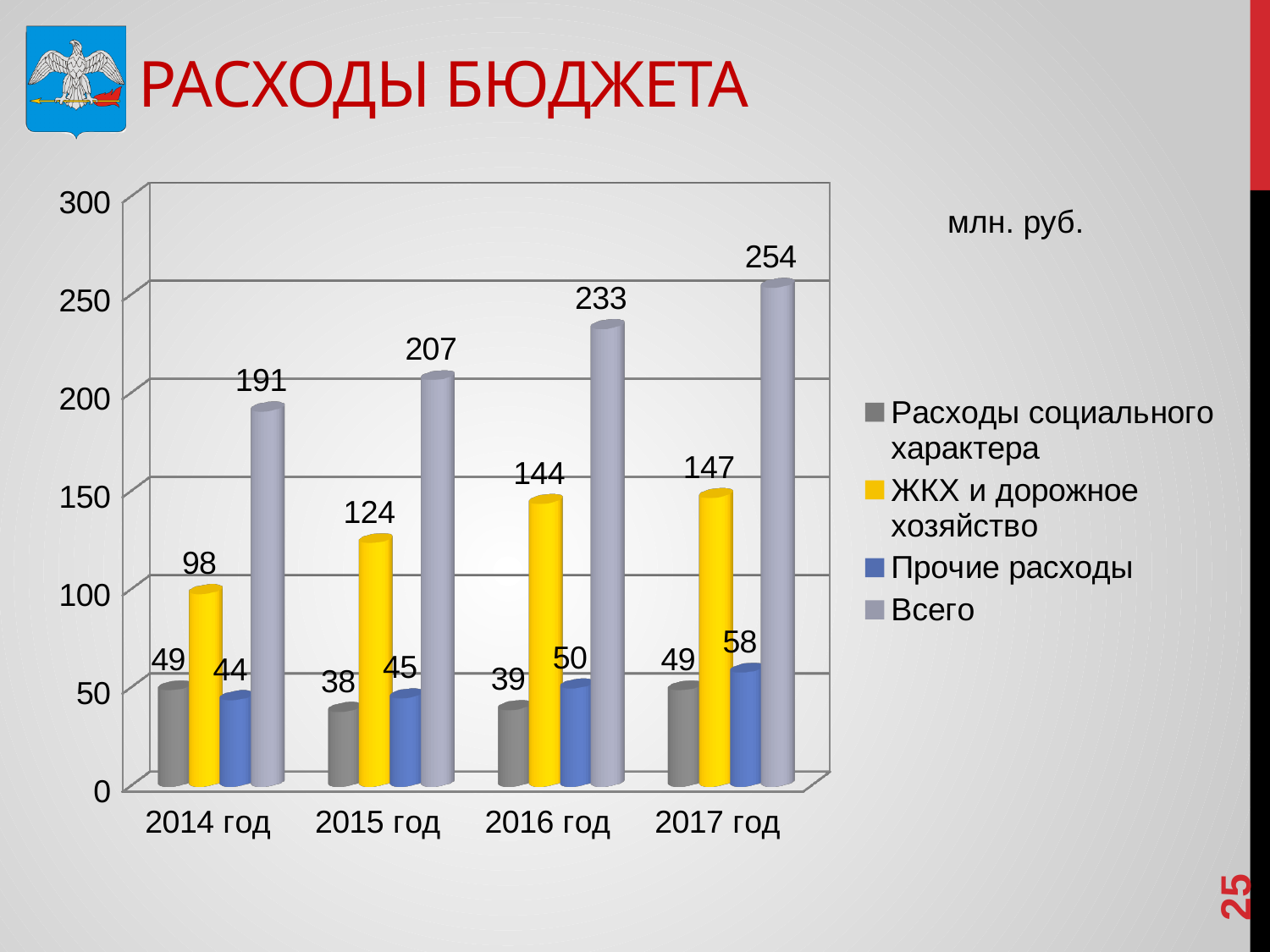
How many years are shown on the x axis? 4 What is the value of «ЖКХ и дорожное хозяйство» for 2015 год? 124 What kind of chart is shown on the slide? Bar chart In which year is «Всего» the highest? 2017 год How many series does the legend list? 4 What is the difference between «Всего» in 2017 год and «Всего» in 2014 год? 63 In which year is «Расходы социального характера» the lowest? 2015 год What is the value of «Расходы социального характера» for 2016 год? 39 What is the value of «Всего» for 2017 год? 254 What is the value of «Прочие расходы» for 2014 год? 44 Does «Всего» rise or fall from 2014 год to 2017 год? Rises Which is larger: «ЖКХ и дорожное хозяйство» in 2016 год or «ЖКХ и дорожное хозяйство» in 2015 год? 2016 год